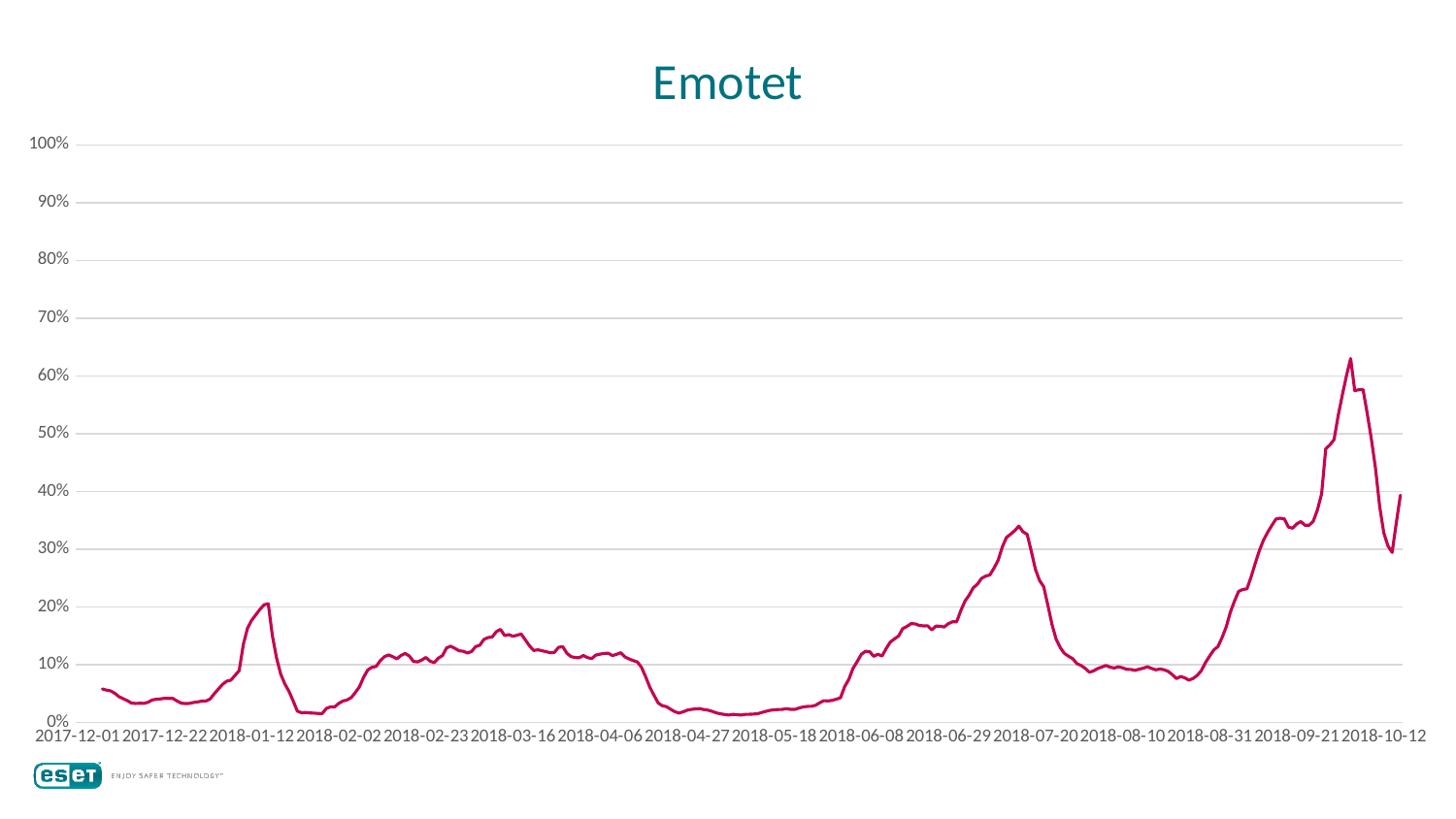
Which is larger, the value at 2018-10-12 or the value at 2017-12-01? 2018-10-12 Is the value at 2017-12-01 greater or less than 10%? less Does the line rise or fall between 2018-08-31 and 2018-09-21? rise Is the value at 2018-06-29 greater or less than 10%? greater How many date labels are shown along the x axis? 16 Is the peak value of the line greater or less than 50%? greater What kind of chart is shown on the slide? line chart What is the highest value shown on the y axis? 100% What is the title of the chart? Emotet